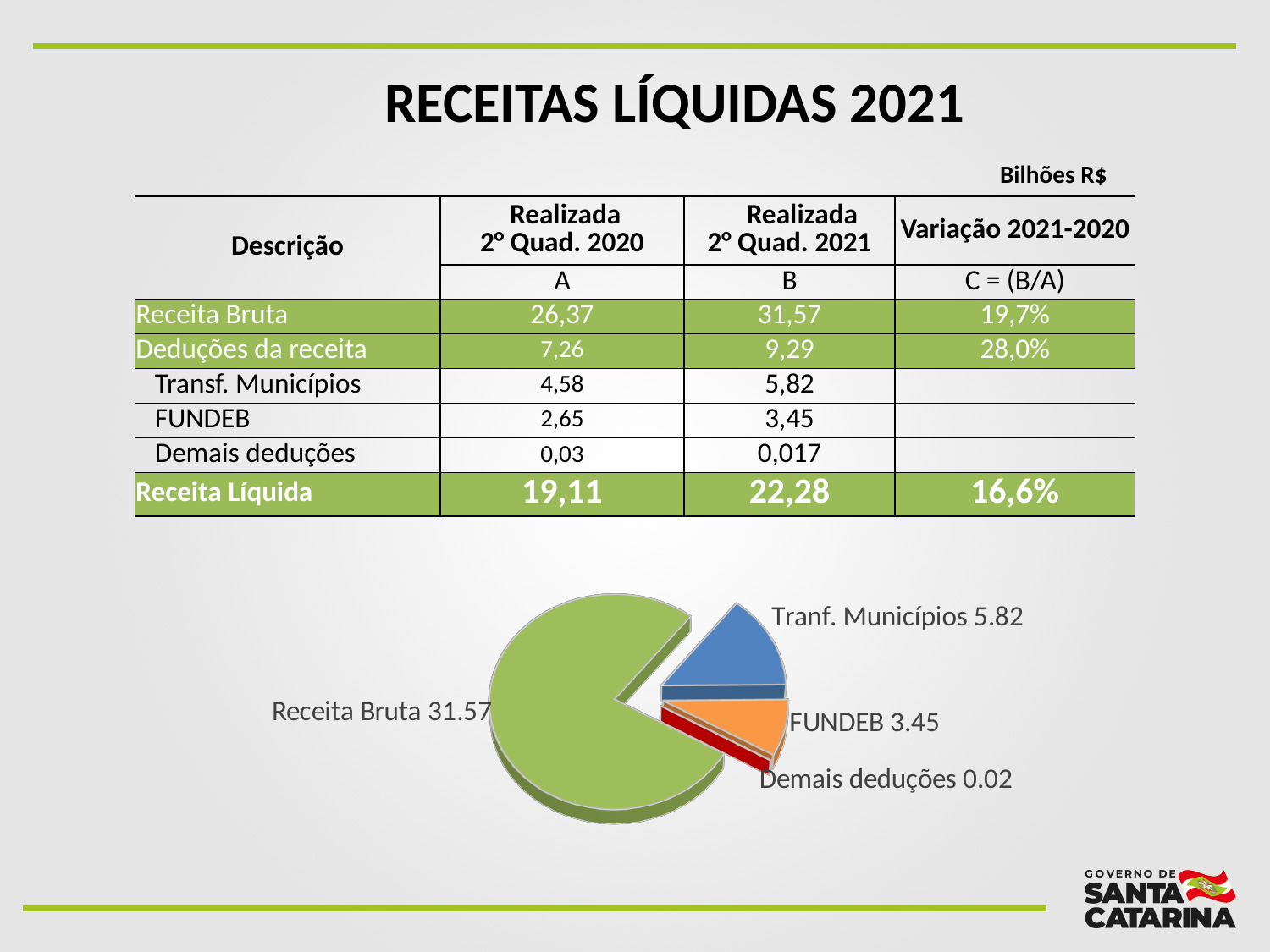
What colour is the Receita Bruta slice in the pie chart? Green In the pie chart, what is the value shown for Receita Bruta? 31.57 In the pie chart, what is the difference between the Tranf. Municípios value and the FUNDEB value? 2.37 In the pie chart, what is the value shown for Tranf. Municípios? 5.82 Which slice of the pie chart is the largest? Receita Bruta In the pie chart, what is the value shown for FUNDEB? 3.45 In the pie chart, which is larger: Tranf. Municípios or FUNDEB? Tranf. Municípios How many slices does the pie chart have? 4 Which slice of the pie chart is the smallest? Demais deduções What kind of chart is shown at the bottom of the slide? Pie chart In the pie chart, what is the value shown for Demais deduções? 0.02 In the pie chart, what is the difference between the Receita Bruta value and the Tranf. Municípios value? 25.75